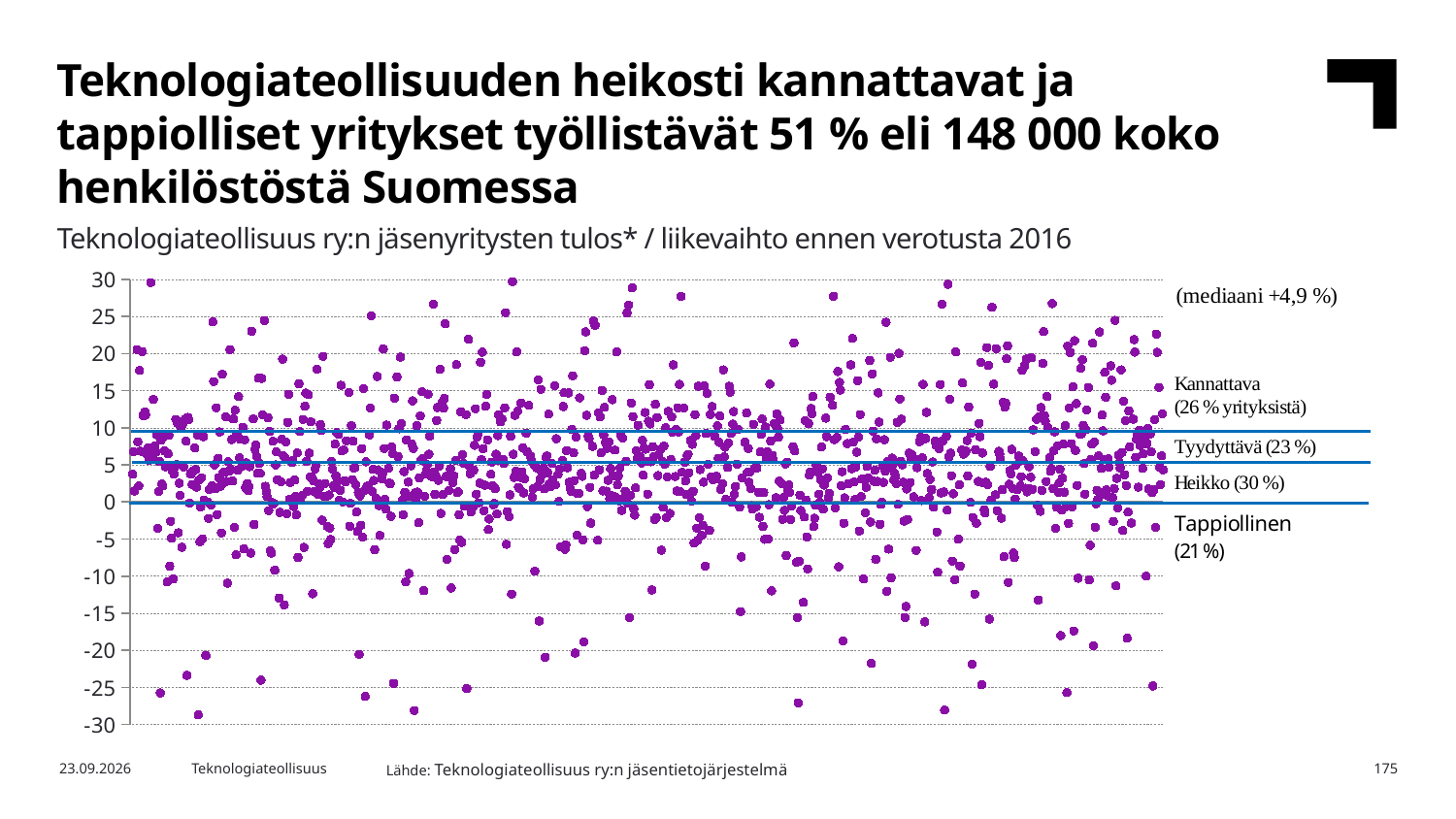
Which profitability category contains the largest share of companies? Heikko How many percentage points larger is the Heikko share than the Tappiollinen share? 9 Which category has a larger share of companies, Kannattava or Tyydyttävä? Kannattava What share of companies falls into the Tyydyttävä category? 23 % What share of companies falls into the Tappiollinen category? 21 % What share of companies falls into the Kannattava category? 26 % What is the median value noted on the chart? +4,9 % Which profitability category contains the smallest share of companies? Tappiollinen What is the highest value shown on the vertical axis? 30 How many profitability categories are labelled on the chart? 4 What kind of chart is shown on the slide? Scatter plot What share of companies falls into the Heikko category? 30 %